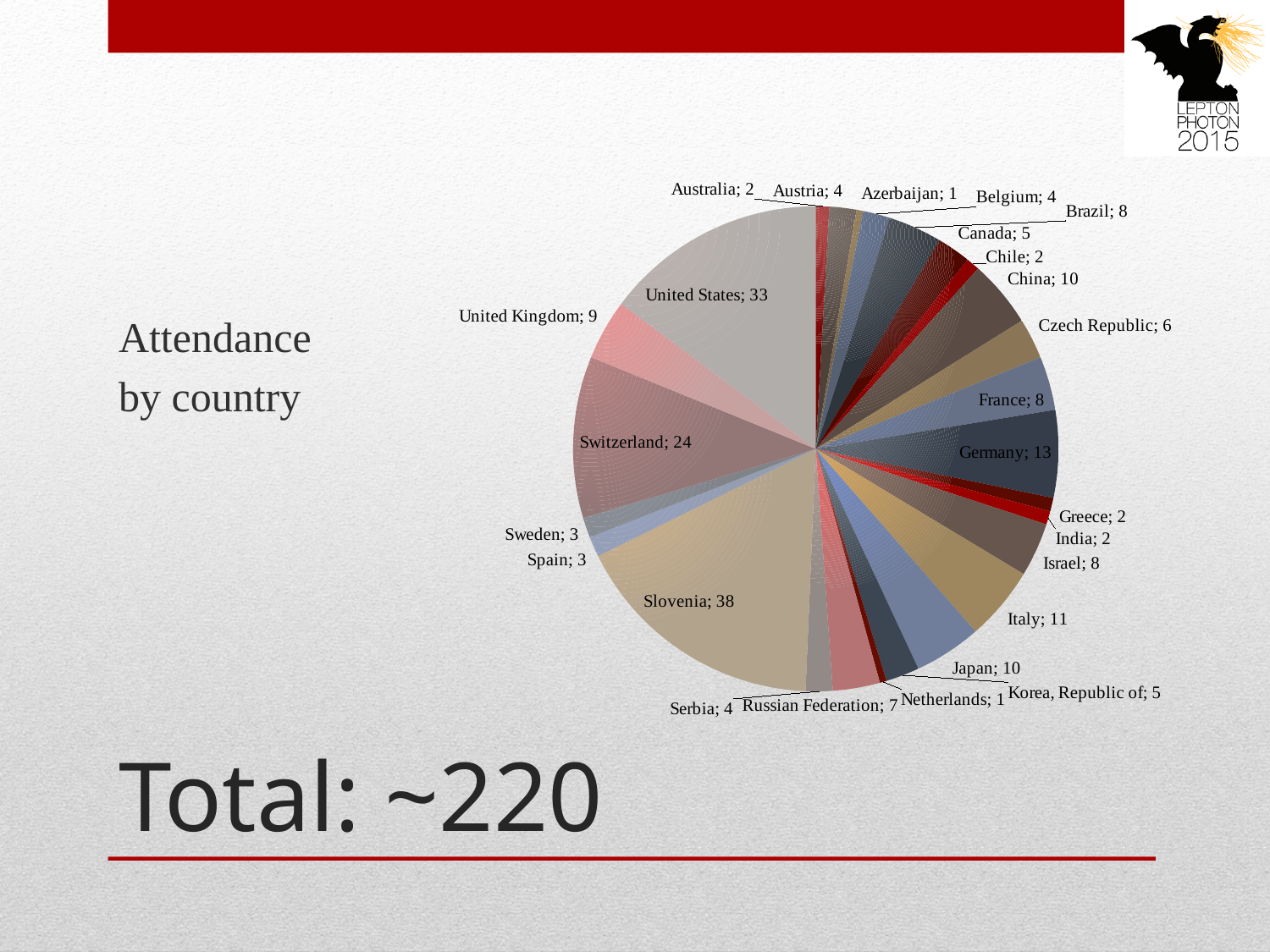
What is the title of the chart? Attendance by country How many attendees are from Switzerland? 24 Which has more attendees, Switzerland or Germany? Switzerland What is the difference between the attendance from Slovenia and from the United States? 5 How many attendees are from Slovenia? 38 What kind of chart is shown on the slide? pie chart What is the difference between the attendance from Italy and from Japan? 1 How many attendees are from the Russian Federation? 7 Which country has the largest slice of the pie? Slovenia Which has more attendees, China or Czech Republic? China How many countries are shown in the pie chart? 26 How many attendees are from Germany? 13